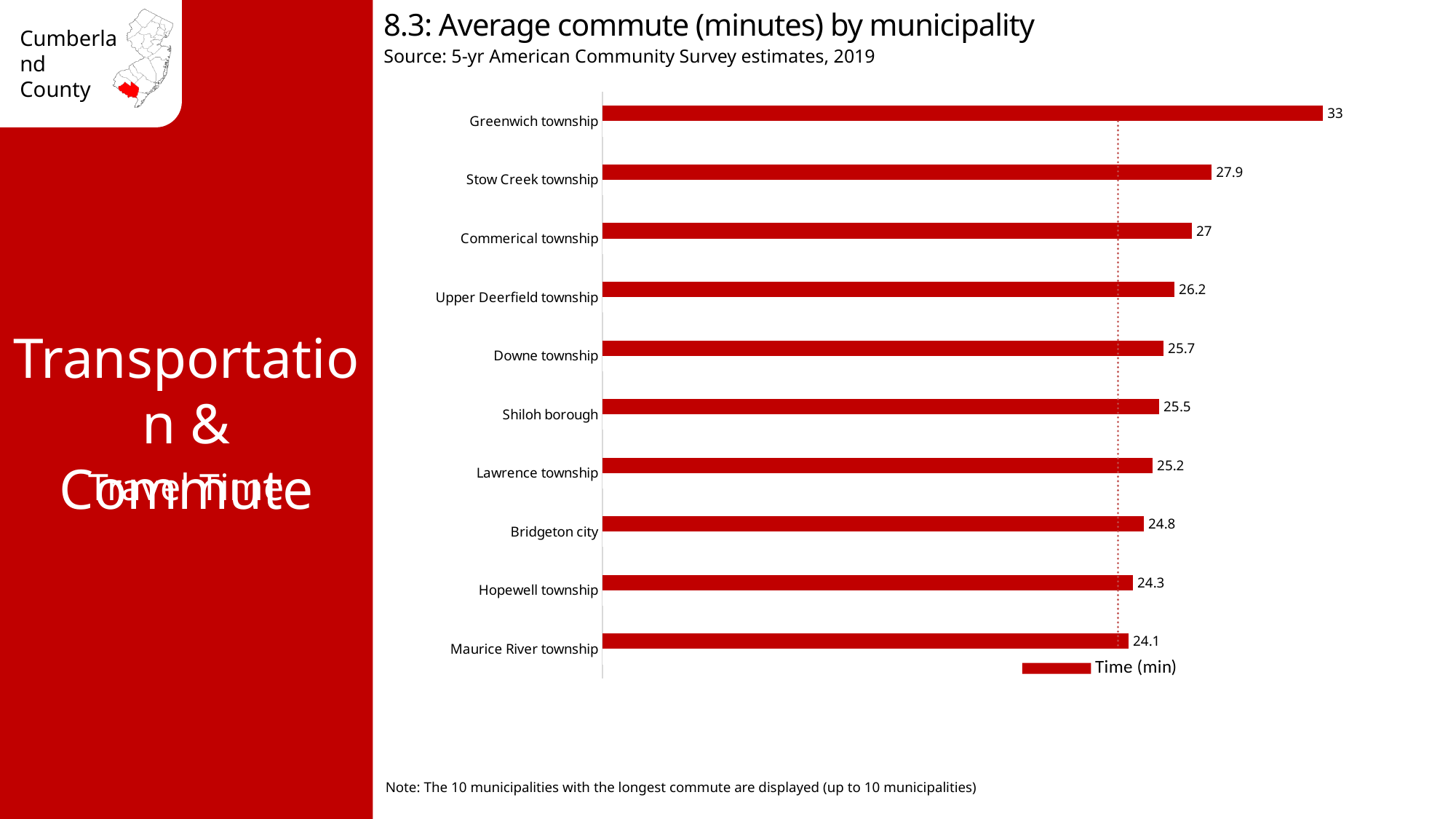
What is the difference in average commute between Commerical township and Hopewell township? 2.7 What is the average commute time for Bridgeton city? 24.8 How many municipalities are shown in the chart? 10 How many series does the legend list? 1 What is the legend entry for the series in the chart? Time (min) Which municipality shown has the shortest average commute? Maurice River township What kind of chart is shown on the slide? Bar chart What is the average commute time for Greenwich township? 33 Which has a longer average commute, Upper Deerfield township or Downe township? Upper Deerfield township What is the difference in average commute between Greenwich township and Stow Creek township? 5.1 Which municipality has the longest average commute? Greenwich township What is the average commute time for Shiloh borough? 25.5